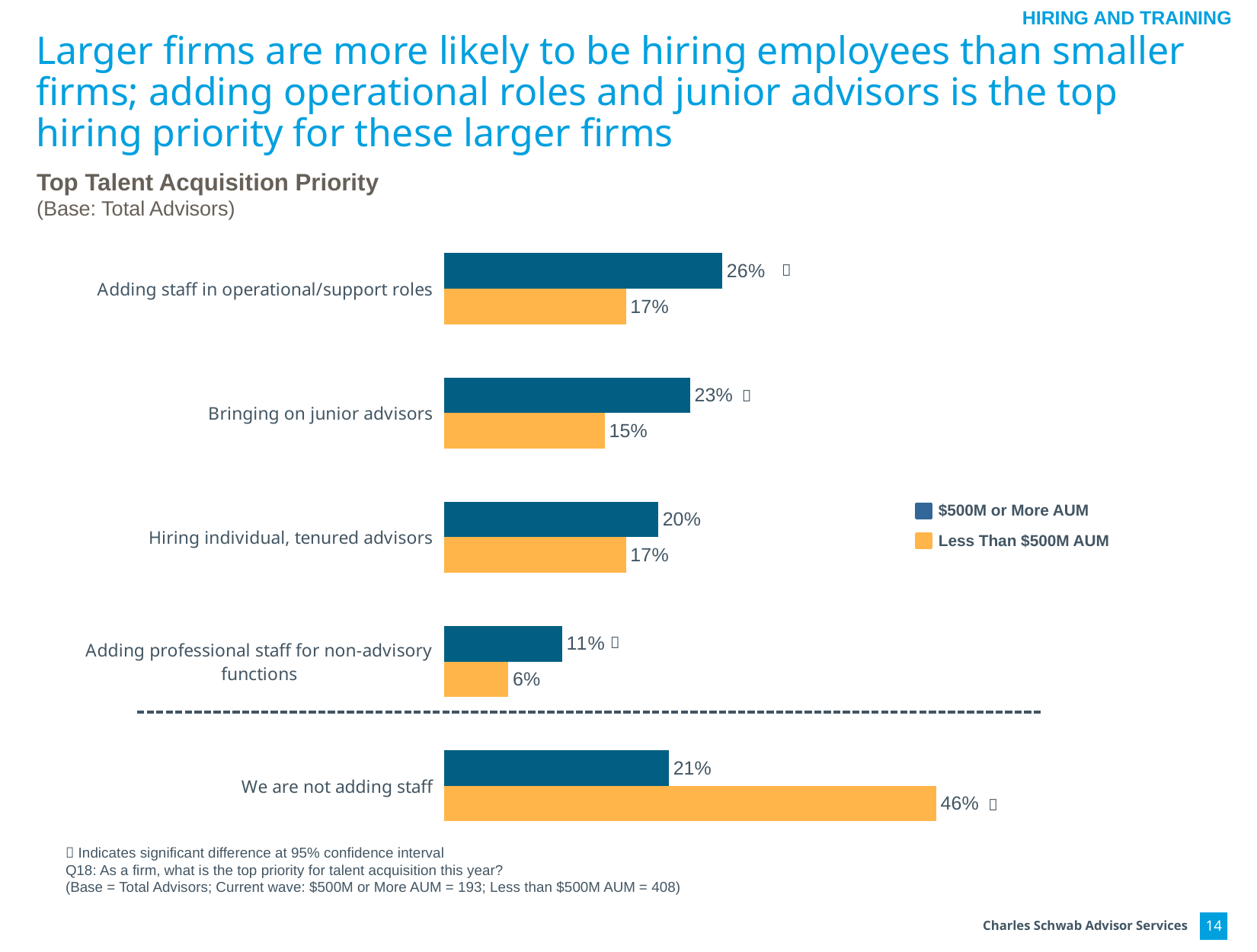
How many series does the legend list? 2 Which category has the lowest value for the $500M or More AUM series? Adding professional staff for non-advisory functions What percentage of $500M or More AUM firms say adding staff in operational/support roles is their top talent acquisition priority? 26% What kind of chart is shown on the slide? Bar chart Which category has the highest value for the Less Than $500M AUM series? We are not adding staff What is the difference between the $500M or More AUM and Less Than $500M AUM values for adding staff in operational/support roles? 9 percentage points What is the difference between the Less Than $500M AUM and $500M or More AUM values for 'We are not adding staff'? 25 percentage points How many categories are shown on the chart? 5 For hiring individual, tenured advisors, which group has the larger value: $500M or More AUM or Less Than $500M AUM? $500M or More AUM What is the title of the chart? Top Talent Acquisition Priority What is the value for Less Than $500M AUM firms for bringing on junior advisors? 15% What percentage of Less Than $500M AUM firms say they are not adding staff? 46%